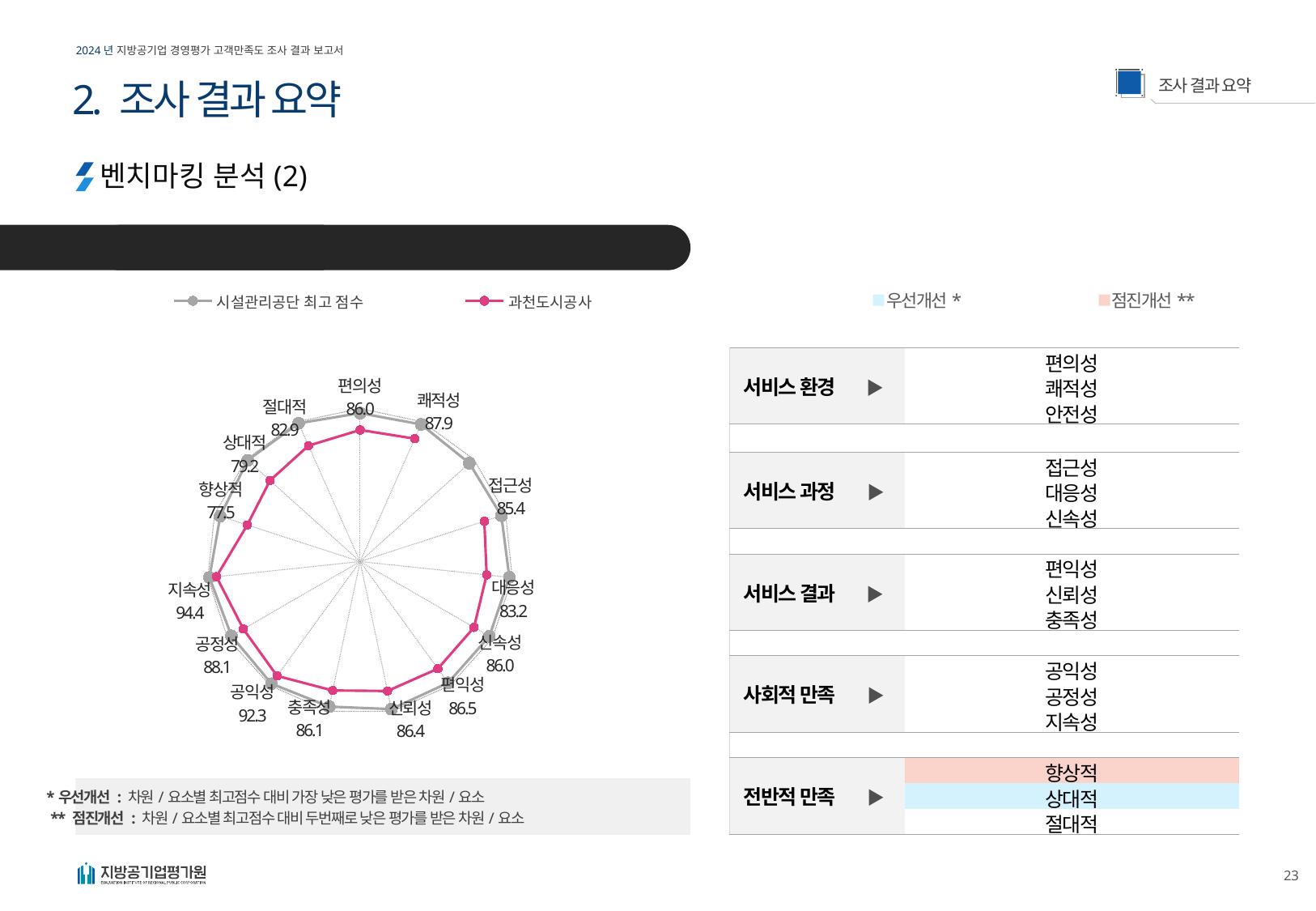
What value is labelled for 지속성 on the chart? 94.4 What are the two series named in the chart legend? 시설관리공단 최고 점수 and 과천도시공사 How many series does the chart legend list? 2 What kind of chart is shown on the slide? Radar chart What value is labelled for 쾌적성 on the chart? 87.9 What is the difference between the labelled values for 지속성 and 향상적? 16.9 Which has the larger labelled value, 쾌적성 or 접근성? 쾌적성 Which labelled category has the highest value on the chart? 지속성 Which labelled category has the lowest value on the chart? 향상적 What value is labelled for 공익성 on the chart? 92.3 What colour is the line for 과천도시공사 in the chart? Pink What value is labelled for 향상적 on the chart? 77.5